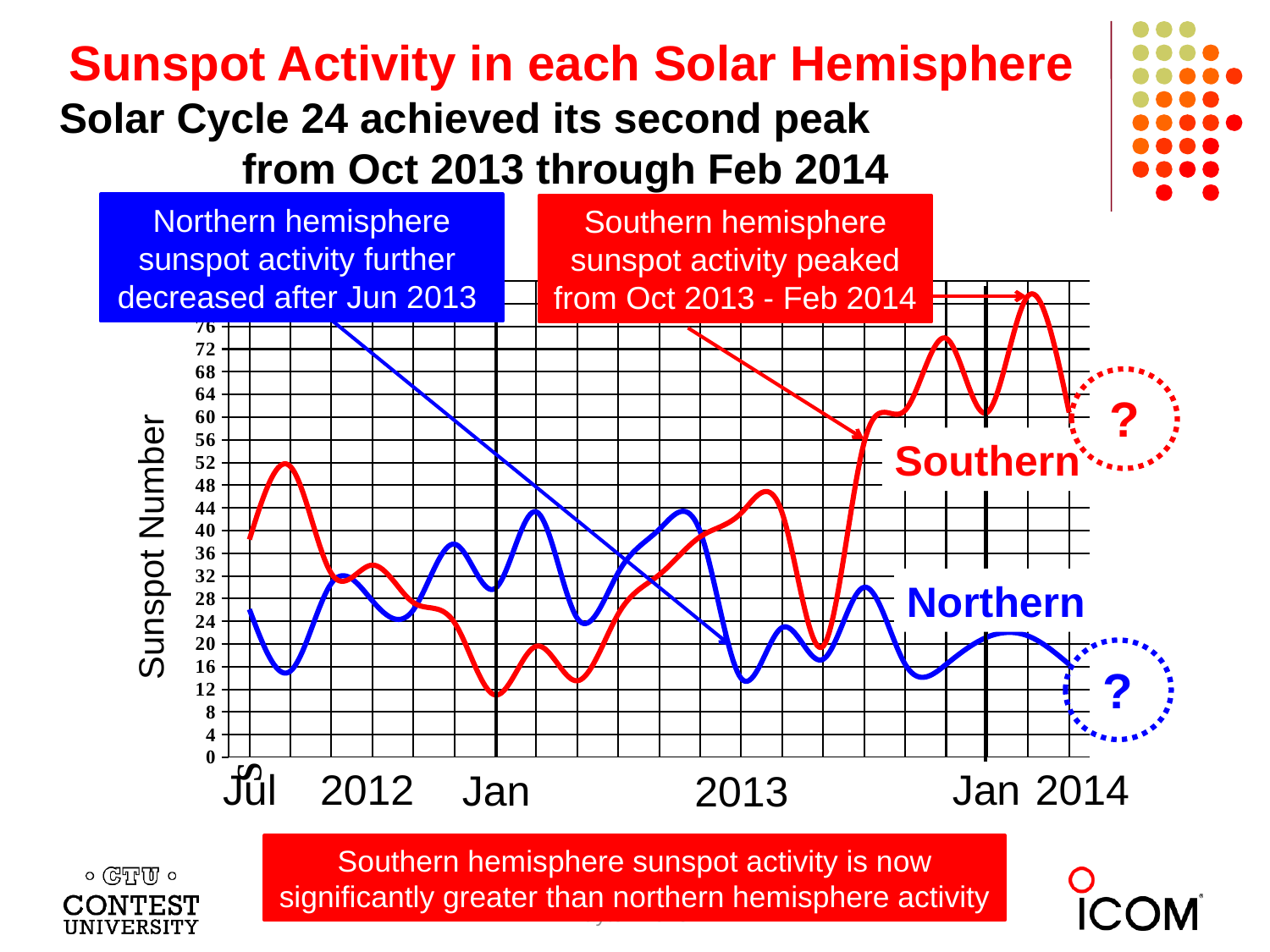
What is the label on the vertical axis of the chart? Sunspot Number What is the highest tick value shown on the vertical axis? 76 What kind of chart is shown on the slide? line chart Is the peak value of the Southern series near Jan 2014 greater or less than 70? greater How many data series are plotted on the chart? 2 Which series reaches the highest sunspot number on the chart? Southern At Jan 2013, which series has the larger value, Southern or Northern? Southern At Jan 2014, which series has the larger value, Southern or Northern? Southern Which colour is used for the Southern hemisphere line? red Is the value of the Southern series at Jan 2014 greater or less than 40? greater Is the value of the Northern series at Jan 2014 greater or less than 30? less Does the Southern series rise or fall between mid-2013 and Jan 2014? rise